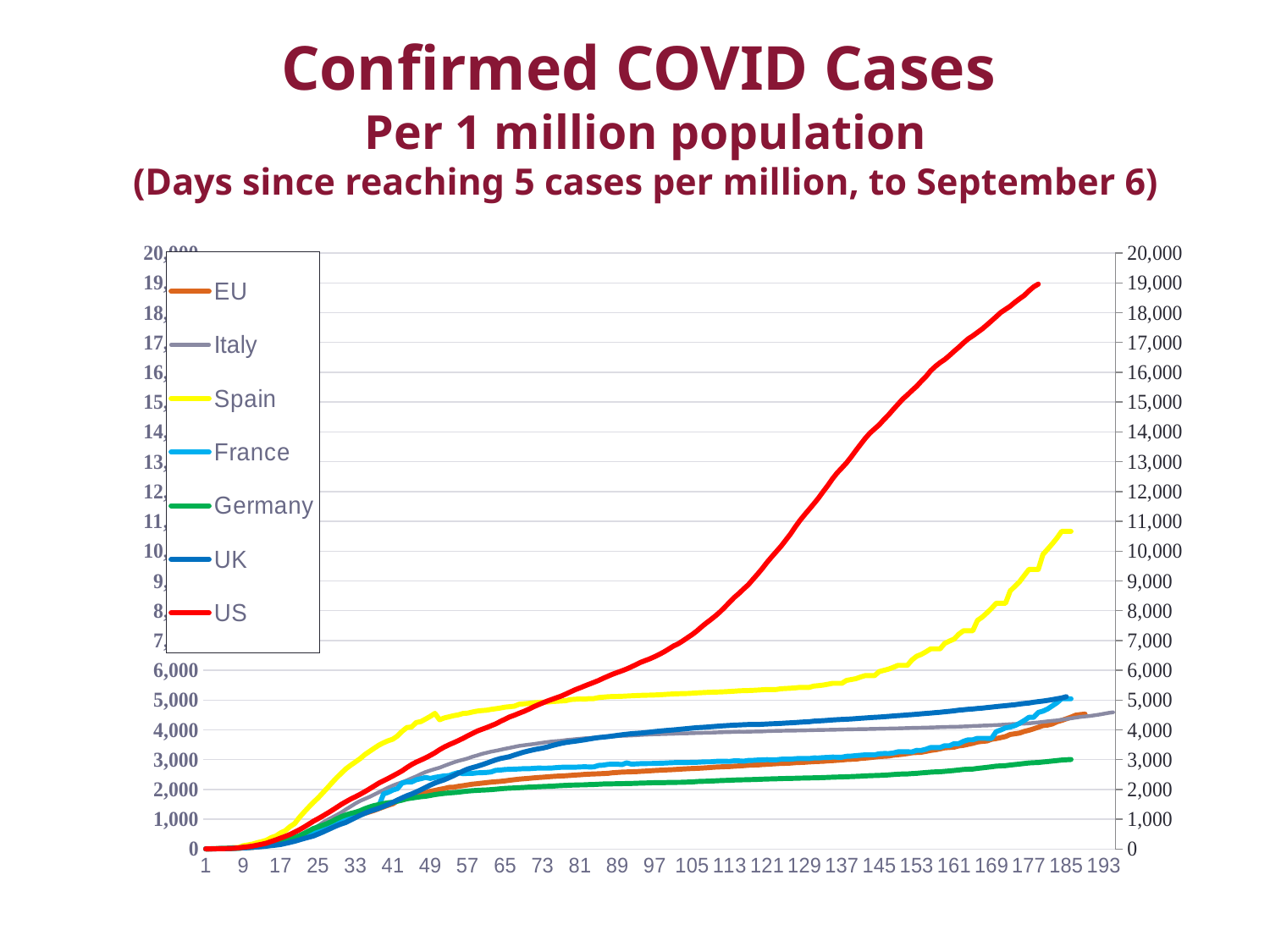
Is the final value for Germany greater or less than 4,000? less Which series reaches the highest value at the right end of the chart? US Does the US line rise or fall as the days increase along the x axis? rise What colour is the US line in the legend? red Which series has the lowest value at the right end of the chart? Germany What kind of chart is shown on the slide? line chart Is the final value for the UK greater or less than 4,000? greater Is the final value for Spain greater or less than 10,000? greater At the right end of the chart, which is larger, the US line or the Spain line? US How many series does the legend list? 7 At the right end of the chart, which is larger, the Spain line or the Germany line? Spain